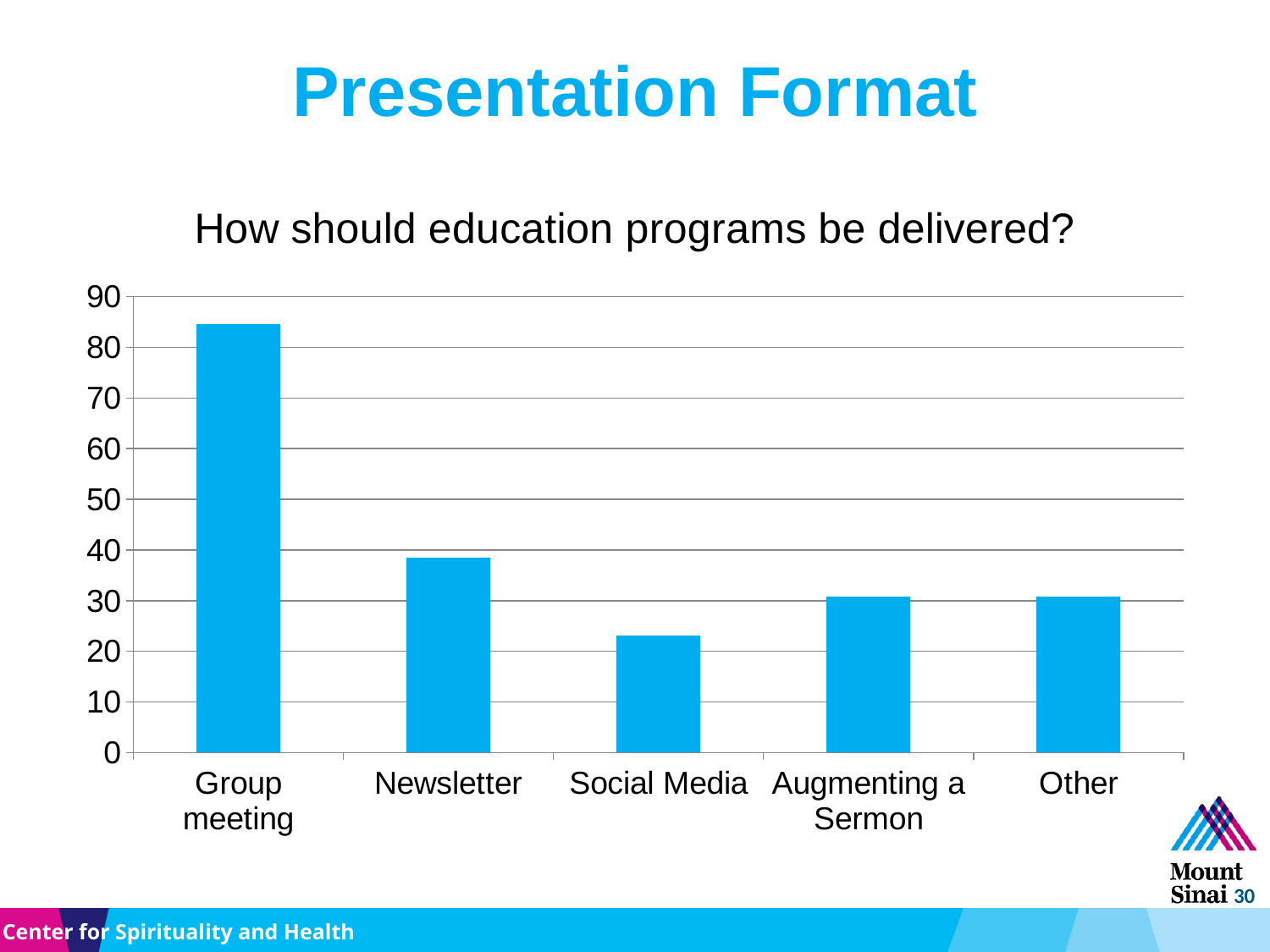
What is the highest value shown on the y axis of the chart? 90 What question does the chart's title ask? How should education programs be delivered? How many categories are shown on the x axis of the chart? 5 Is the value for Group meeting greater or less than 80? greater Which is larger, the value for Other or the value for Group meeting? Group meeting Which is larger, the value for Newsletter or the value for Social Media? Newsletter Is the value for Social Media greater or less than 20? greater Which category has the lowest value in the chart? Social Media Is the value for Newsletter greater or less than 40? less What kind of chart is shown on the slide? bar chart Which category has the highest value in the chart? Group meeting